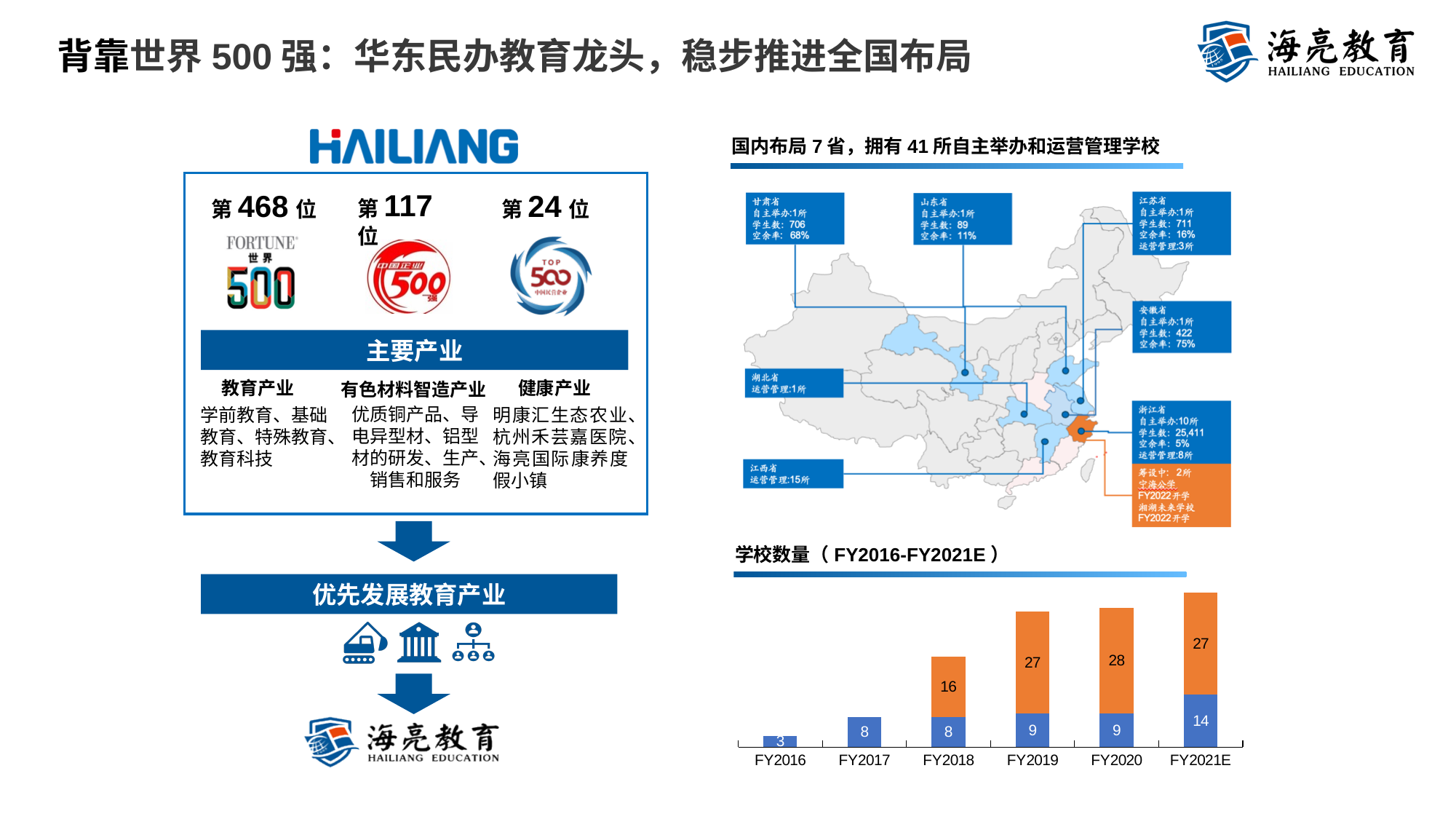
In the 学校数量 chart, do the total bar heights generally rise or fall from FY2016 to FY2021E? Rise In the 学校数量 chart, which fiscal year has the lowest blue segment value? FY2016 In the 学校数量 chart, which is larger: the blue segment for FY2018 or for FY2021E? FY2021E In the 学校数量 chart, what is the difference between the orange segment values for FY2020 and FY2019? 1 How many fiscal years are shown on the x axis of the 学校数量 chart? 6 In the 学校数量 chart, what is the total of the stacked bar for FY2021E? 41 In the 学校数量 chart, what is the total of the stacked bar for FY2018? 24 What type of chart is the 学校数量 chart? Stacked bar chart In the 学校数量 chart, what is the value of the blue (lower) segment for FY2021E? 14 In the 学校数量 chart, what is the value of the orange (upper) segment for FY2019? 27 In the 学校数量 chart, which fiscal year has the highest blue segment value? FY2021E In the 学校数量 chart, what is the value of the blue segment for FY2016? 3